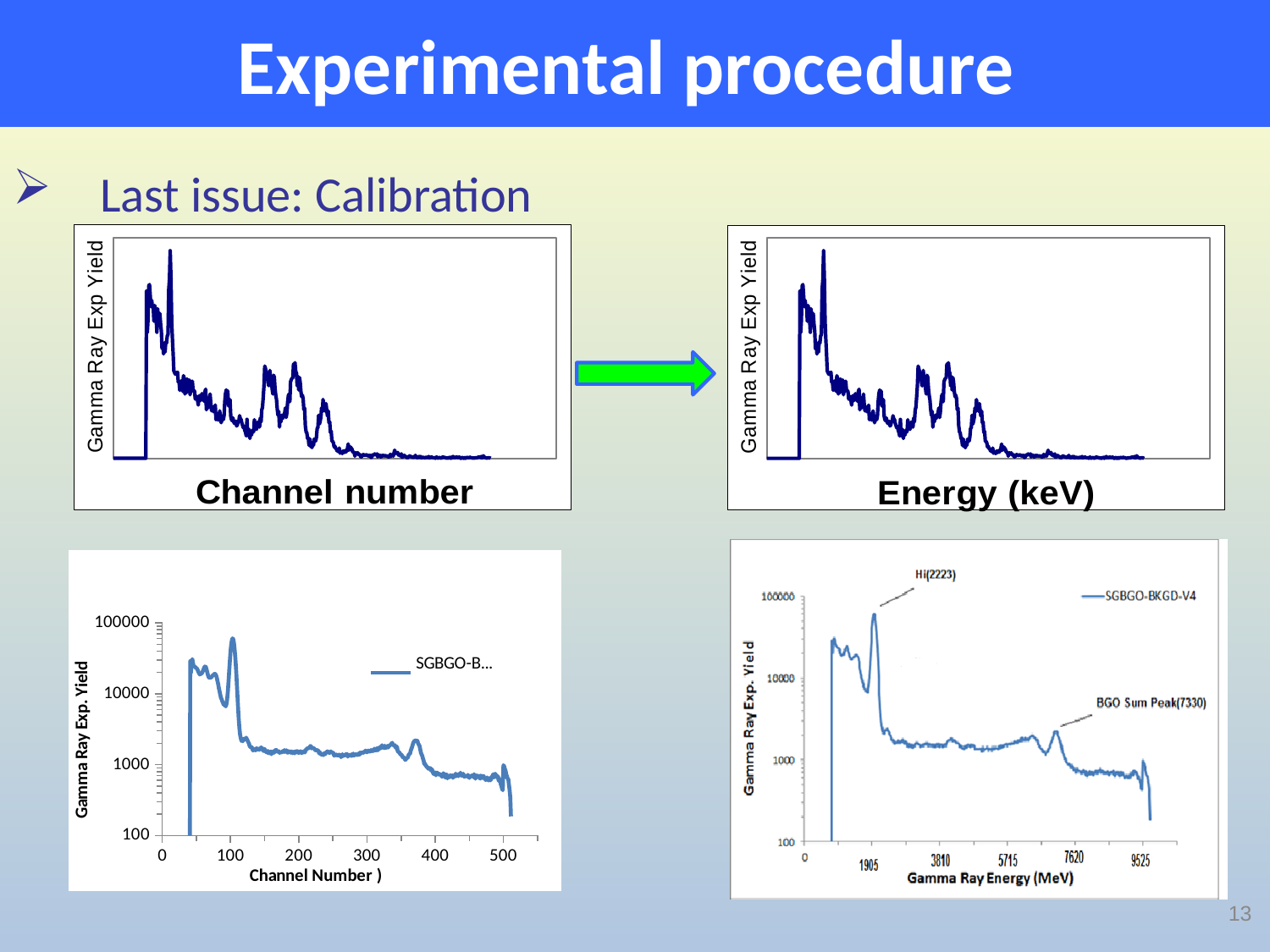
In the bottom-right chart, is the value at the "BGO Sum Peak(7330)" greater or less than 10000? less What kind of chart is the bottom-left chart with the x-axis labelled "Channel Number"? line chart In the bottom-left chart, is the value at channel 450 greater or less than 1000? less What is the x-axis label of the top-right chart? Energy (keV) In the bottom-left chart, is the peak value near channel 100 greater or less than 10000? greater In the bottom-right chart, how many series does the legend list? 1 How many charts are shown on the slide? 4 In the bottom-right chart, which of the two labelled peaks is higher, Hi(2223) or BGO Sum Peak(7330)? Hi(2223) What is the x-axis label of the top-left chart? Channel number In the bottom-left chart, do the values generally rise or fall from channel 100 to channel 500? fall